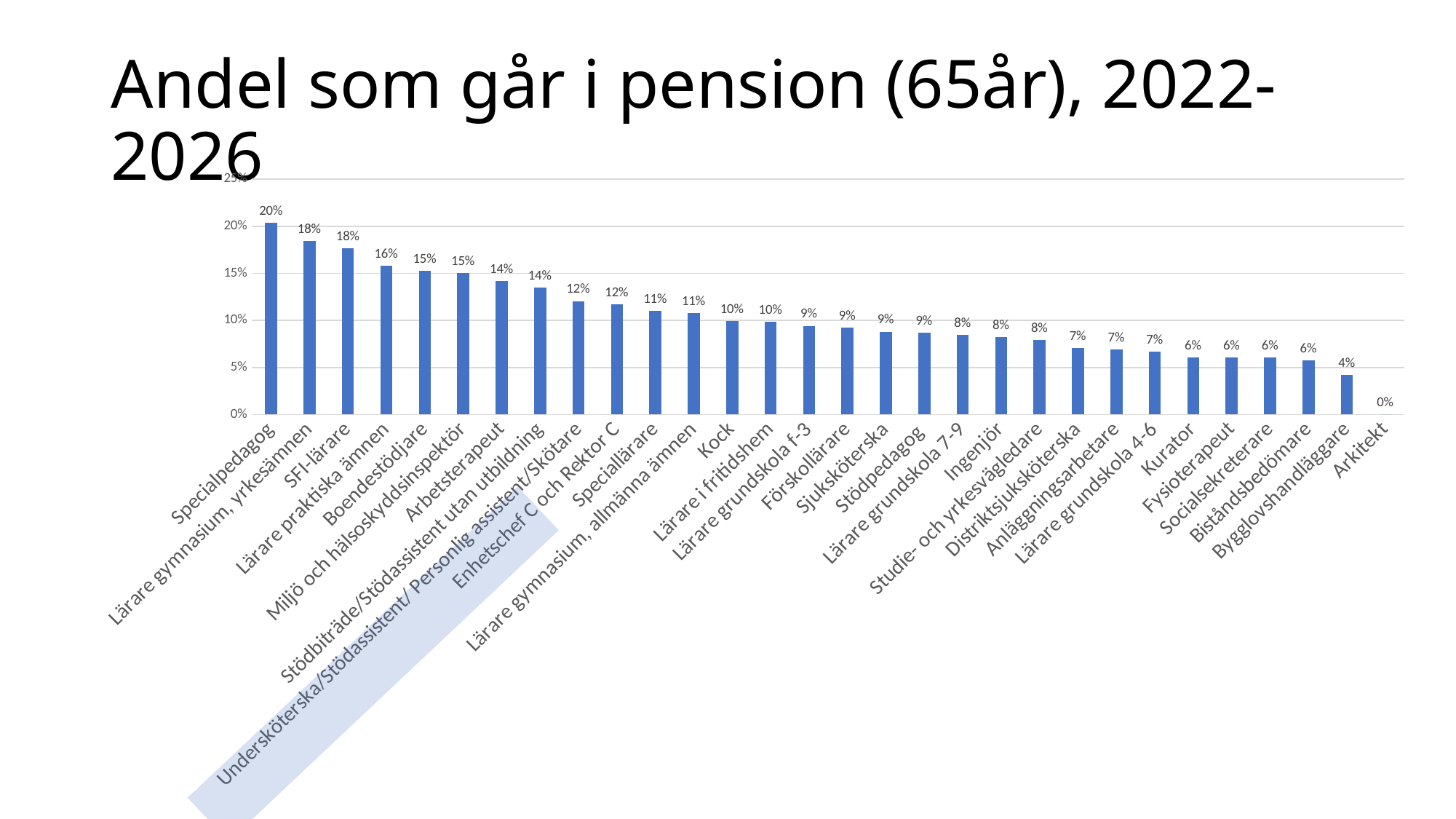
Do the values rise or fall from left to right along the x axis? Fall How many categories are shown in the chart? 30 Which category has the highest value? Specialpedagog What kind of chart is shown on the slide? Bar chart What is the value for Bygglovshandläggare? 4% What is the value for Kock? 10% What is the value for Arbetsterapeut? 14% What is the difference between the values for Specialpedagog and Arkitekt? 20% Which category has the lowest value? Arkitekt What is the difference between the values for Lärare praktiska ämnen and Kurator? 10% What is the value for Specialpedagog? 20% Which has a larger value, Boendestödjare or Ingenjör? Boendestödjare